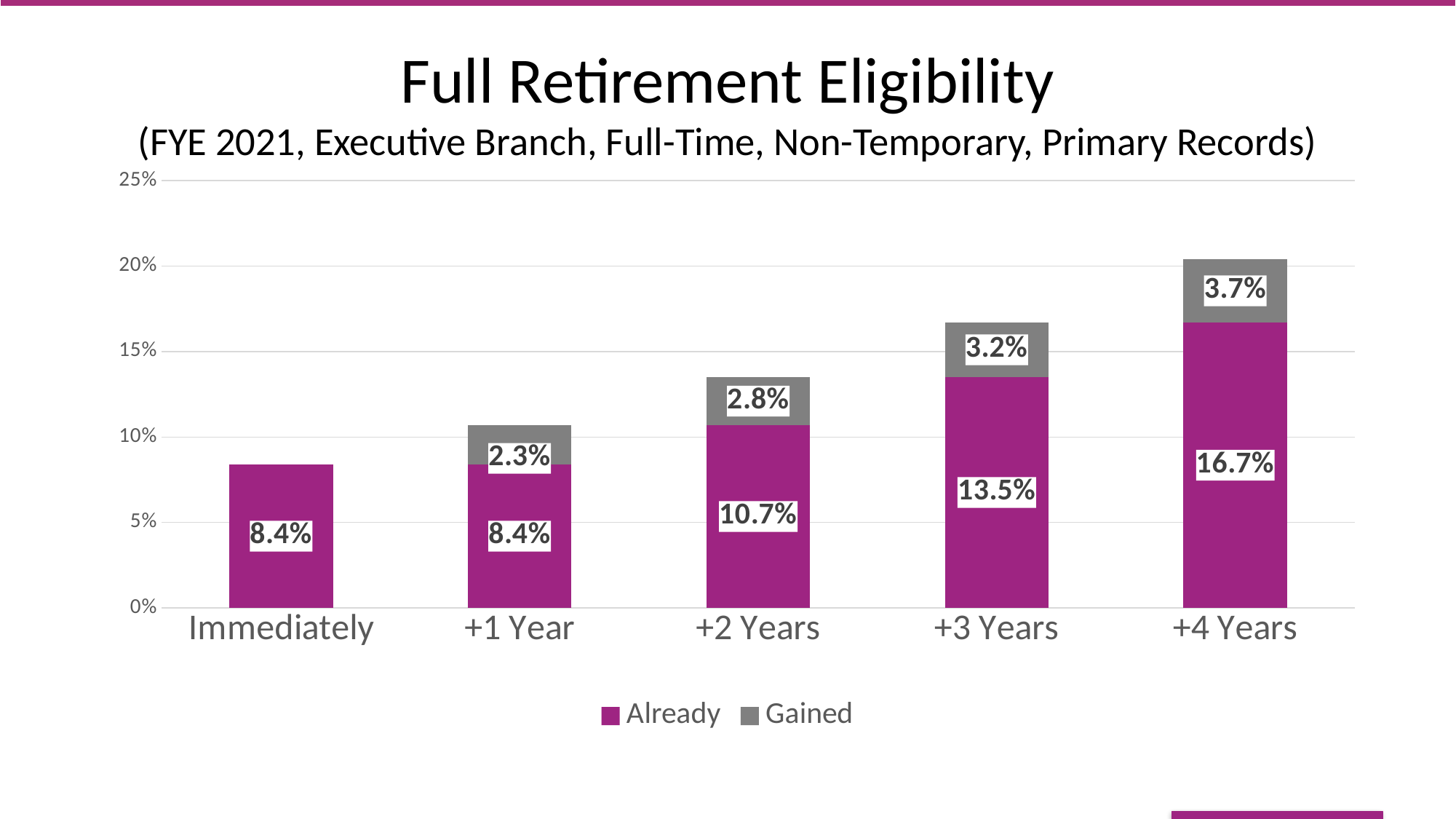
What kind of chart is shown? Stacked bar chart Which is larger, the 'Gained' value for +2 Years or for +4 Years? +4 Years What is the total of the stacked bar for +1 Year? 10.7% Which category has the highest 'Already' value? +4 Years What is the difference between the 'Already' values for +4 Years and +3 Years? 3.2% What is the 'Already' value for Immediately? 8.4% Is the total stacked bar for +4 Years greater or less than 20%? greater What is the 'Already' value for +2 Years? 10.7% Which category has the lowest 'Gained' value among those with a Gained segment? +1 Year How many categories are shown on the x axis? 5 How many series does the legend list? 2 What is the 'Gained' value for +3 Years? 3.2%